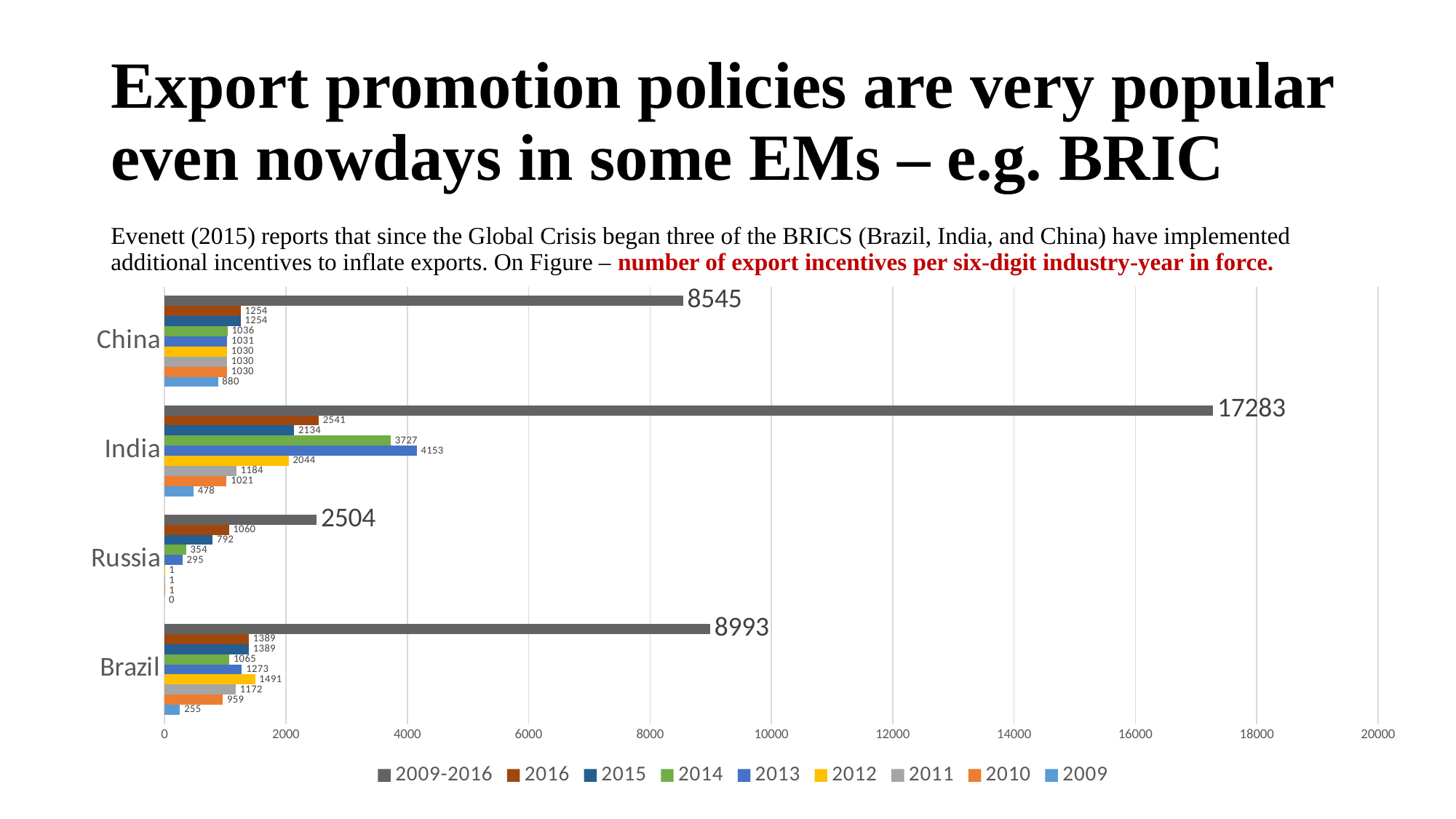
What is the 2009-2016 value for India? 17283 What is the 2009-2016 value for Russia? 2504 Which country has the highest 2009-2016 value? India How many series does the legend list? 9 What is the difference between the 2009-2016 values for Brazil and China? 448 What is the 2012 value for Brazil? 1491 Which country has the lowest 2009-2016 value? Russia Is the 2009-2016 value for India greater or less than 16000? greater What type of chart is shown on the slide? bar chart How many countries are shown on the chart? 4 What is the 2013 value for India? 4153 Which is larger, the 2014 value for India or the 2014 value for Brazil? India